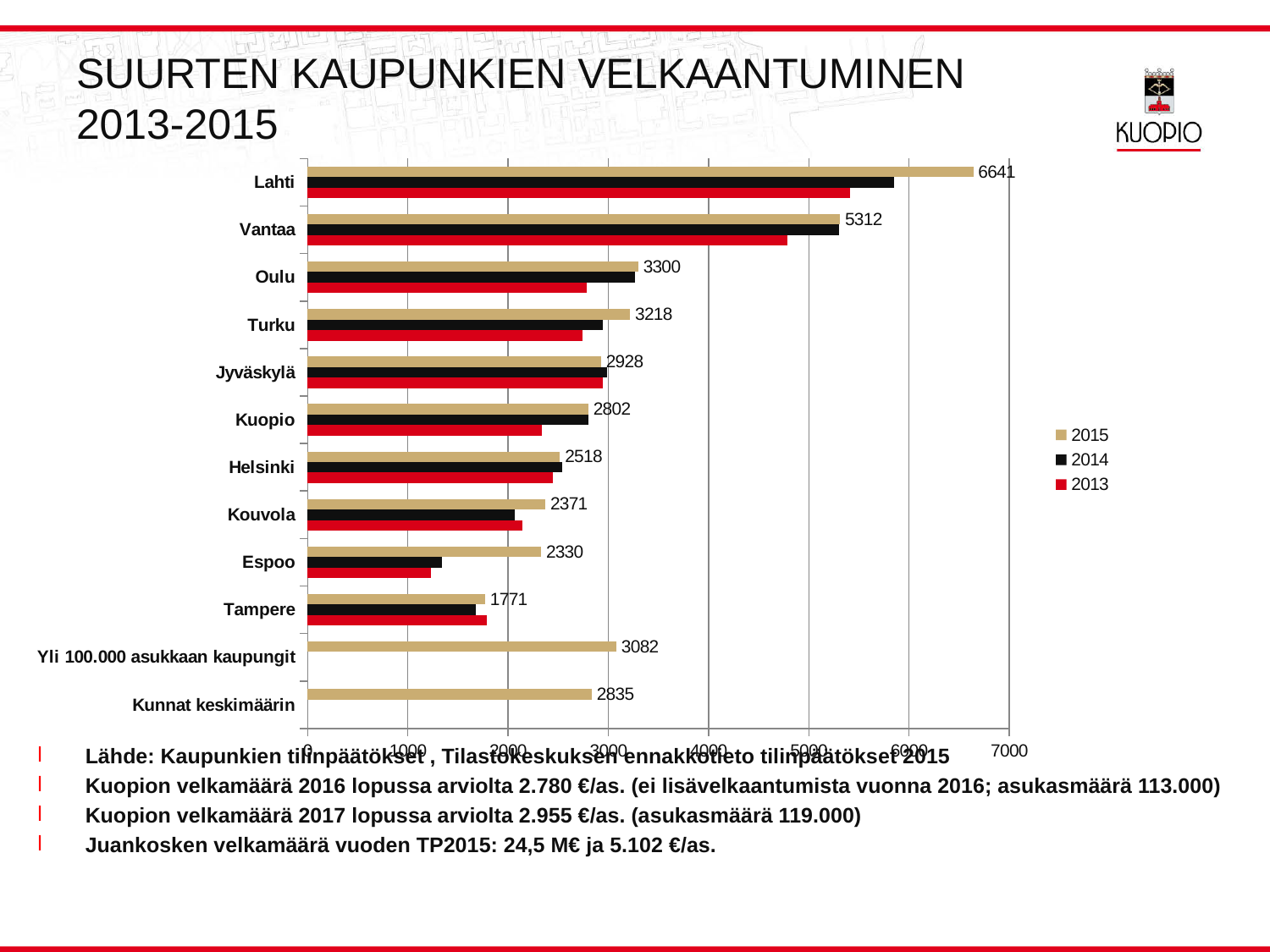
Which city has the lowest 2015 value? Tampere What kind of chart is shown on the slide? bar chart What is the difference between the 2015 values for Lahti and Vantaa? 1329 What is the 2015 value for Lahti? 6641 How many series does the legend list? 3 Which has the larger 2015 value, Kuopio or Kunnat keskimäärin? Kunnat keskimäärin How many categories are shown on the vertical axis? 12 What is the 2015 value for Kuopio? 2802 Is the 2014 value for Espoo greater or less than 2000? less Which city has the highest 2015 value? Lahti Is the 2013 value for Lahti greater or less than 5000? greater What is the 2015 value for Kunnat keskimäärin? 2835